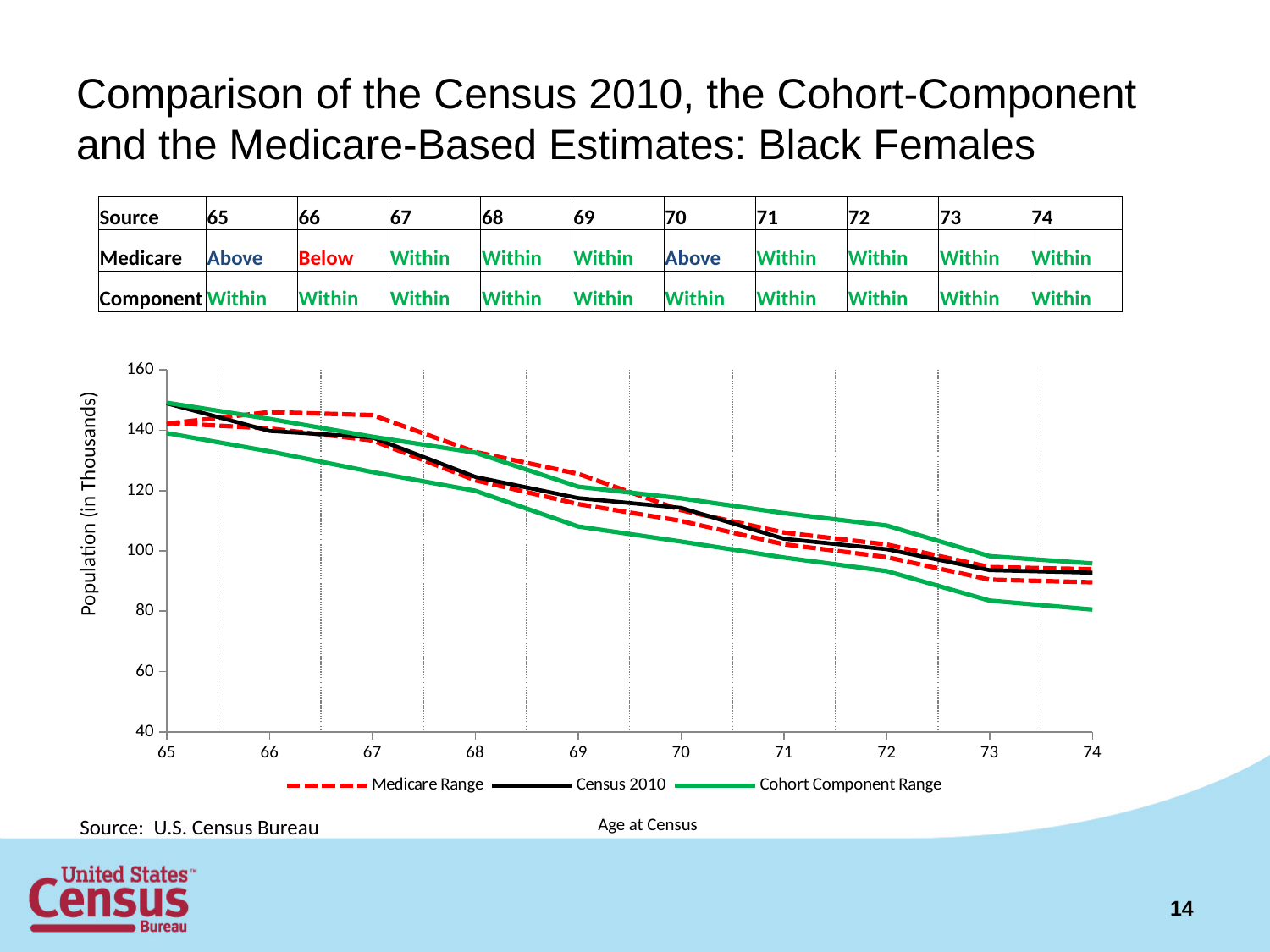
Is the Census 2010 value at age 70 greater or less than 120? less Is the Census 2010 value at age 74 greater or less than 100? less Which is larger for Census 2010: the value at age 65 or the value at age 74? age 65 Is the Census 2010 value at age 65 greater or less than 140? greater Does the Census 2010 line rise or fall as age increases from 65 to 74? fall How many series does the chart legend list? 3 What kind of chart is shown on the slide? line chart What is the label of the chart's y axis? Population (in Thousands) At which age is the Census 2010 value lowest? 74 At which age is the Census 2010 value highest? 65 How many ages are marked along the x axis of the chart? 10